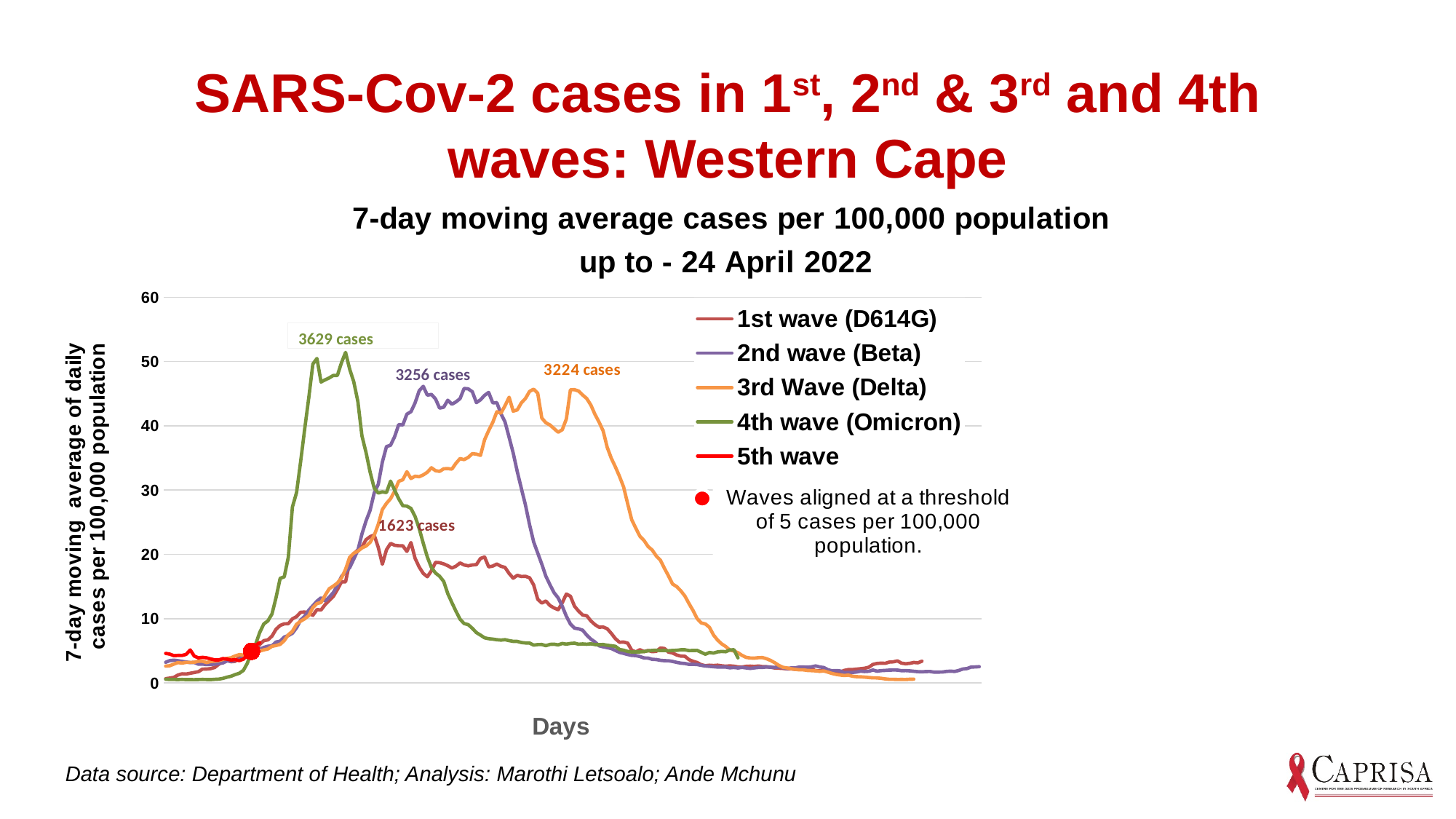
What case count is annotated for the 2nd wave (Beta)? 3256 cases Is the peak value of the 4th wave (Omicron) line greater or less than 50? greater What case count is annotated for the 1st wave (D614G)? 1623 cases How many series does the legend list? 5 What case count is annotated for the 4th wave (Omicron)? 3629 cases What kind of chart is shown on the slide? line chart Which has the larger annotated case count, the 2nd wave (Beta) or the 3rd Wave (Delta)? 2nd wave (Beta) Which wave has the lowest annotated case count? 1st wave (D614G) Is the peak value of the 1st wave (D614G) line greater or less than 30? less What case count is annotated for the 3rd Wave (Delta)? 3224 cases What is the difference between the annotated case counts of the 4th wave and the 3rd wave? 405 Which wave has the highest annotated case count? 4th wave (Omicron)